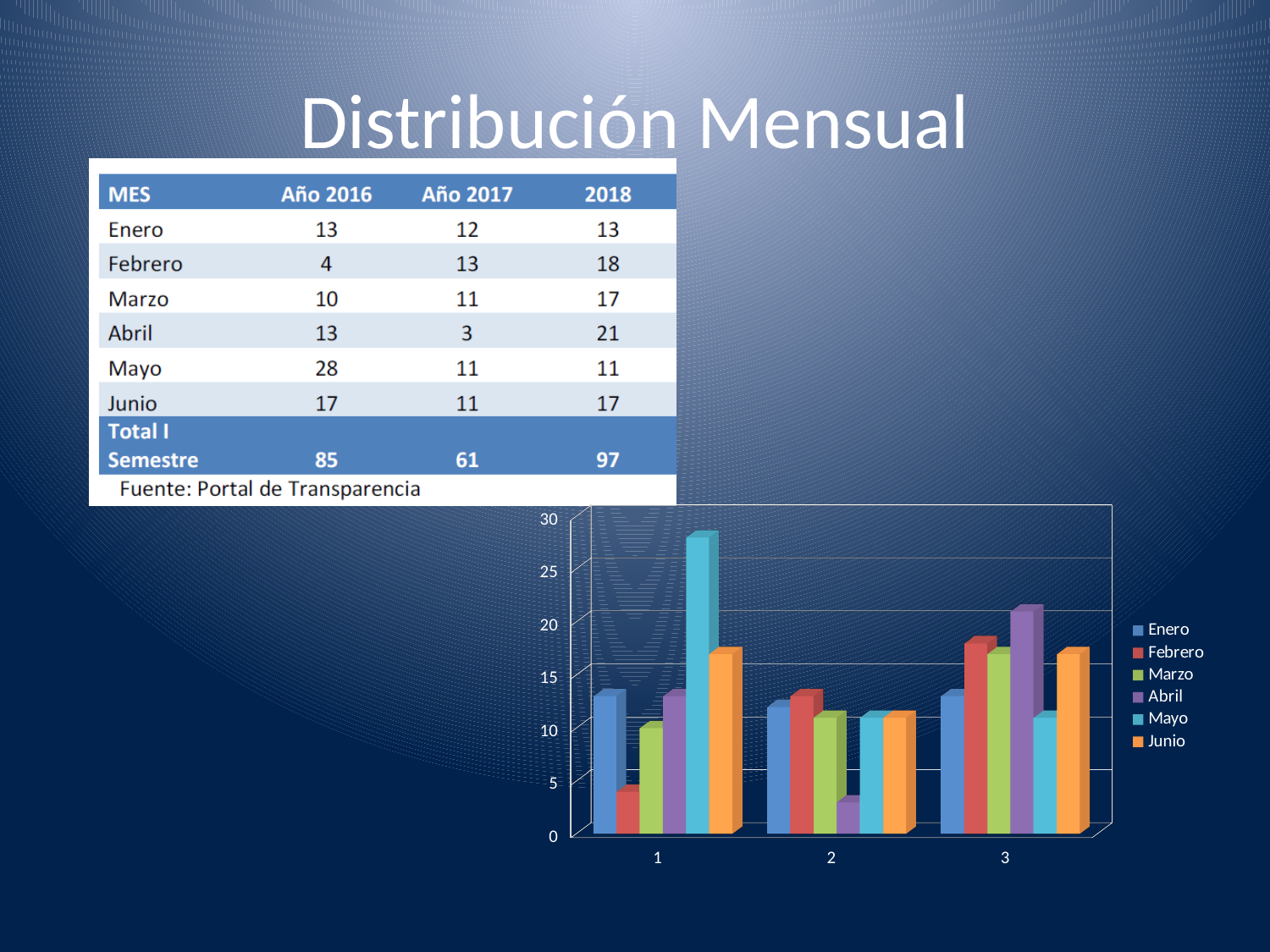
What kind of chart is shown on the slide? bar chart Is the value for Mayo in category 1 greater or less than 25? greater Is the value for Abril in category 2 greater or less than 5? less How many series does the chart's legend list? 6 In category 1 of the chart, which series has the shortest bar? Febrero In category 3 of the chart, which is larger: the Febrero bar or the Mayo bar? Febrero Is the value for Junio in category 3 greater or less than 15? greater How many category groups are shown along the x axis of the chart? 3 In category 1 of the chart, which series has the tallest bar? Mayo Which series is shown in orange in the chart's legend? Junio In category 2 of the chart, which series has the shortest bar? Abril In category 3 of the chart, which series has the tallest bar? Abril